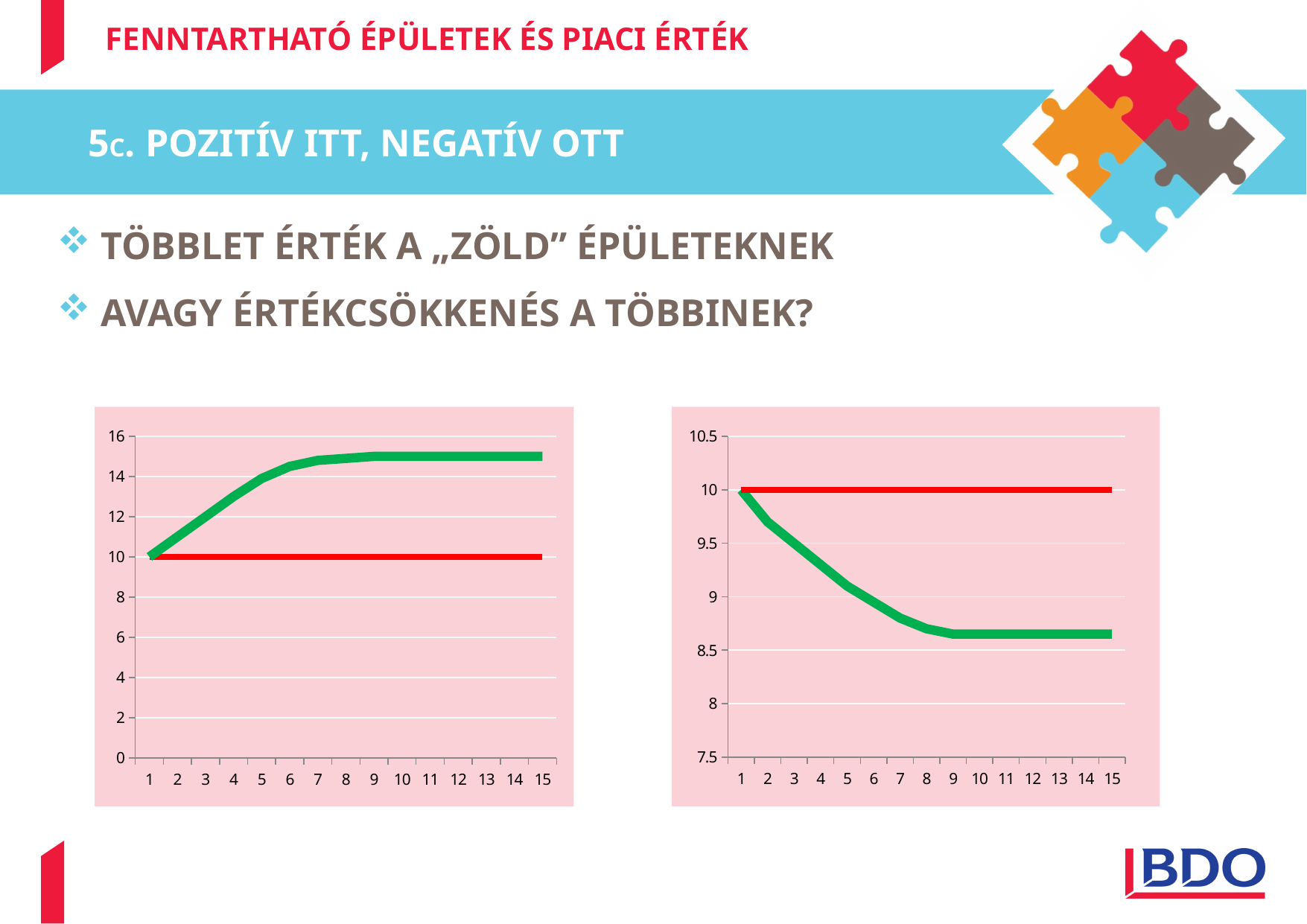
In the chart on the left, at x = 15, which line is higher, the green line or the red line? the green line In the chart on the left, how many points are labelled on the x axis? 15 In the chart on the right, what value does the flat red line sit at? 10 What kind of chart is the chart on the right of the slide? line chart In the chart on the left, is the value of the green line at x = 15 greater or less than 14? greater In the chart on the right, at x = 15, which line is higher, the green line or the red line? the red line In the chart on the right, is the value of the green line at x = 15 greater or less than 9? less What kind of chart is the chart on the left of the slide? line chart In the chart on the right, how many points are labelled on the x axis? 15 In the chart on the left, what value does the flat red line sit at? 10 In the chart on the left, does the green line rise or fall from x = 1 to x = 15? rise In the chart on the right, does the green line rise or fall from x = 1 to x = 15? fall